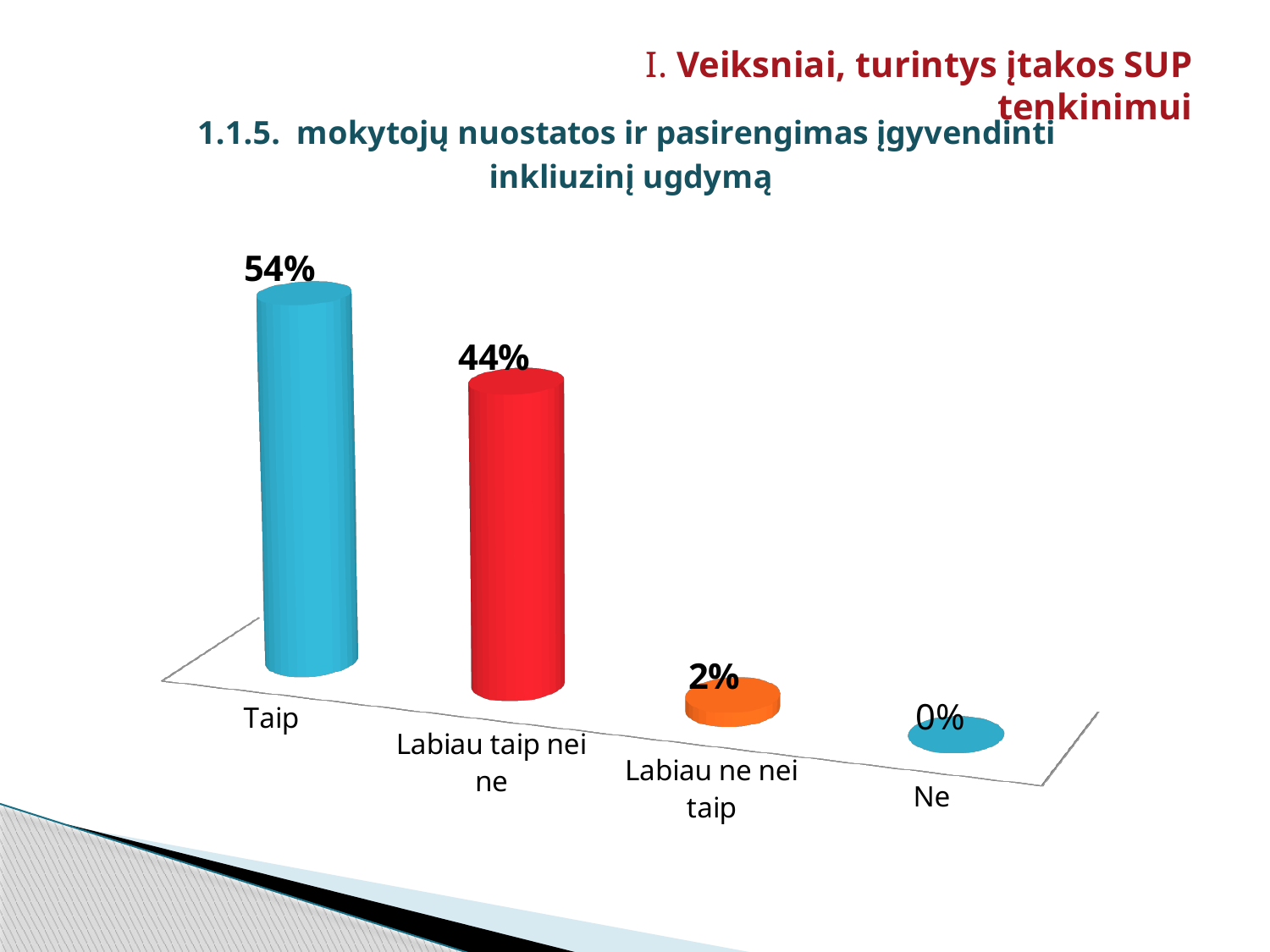
What is the difference between the values for "Taip" and "Labiau taip nei ne"? 10% What is the value for "Labiau taip nei ne"? 44% Which category has the highest value? Taip Which is larger, the value for "Labiau taip nei ne" or the value for "Labiau ne nei taip"? Labiau taip nei ne Which category has the lowest value? Ne What is the value for "Labiau ne nei taip"? 2% What is the value for "Taip"? 54% What kind of chart is shown on the slide? Bar chart What is the value for "Ne"? 0% What colour is the bar for "Labiau taip nei ne"? Red Do the values rise or fall from left to right across the categories? Fall How many categories are shown in the chart? 4